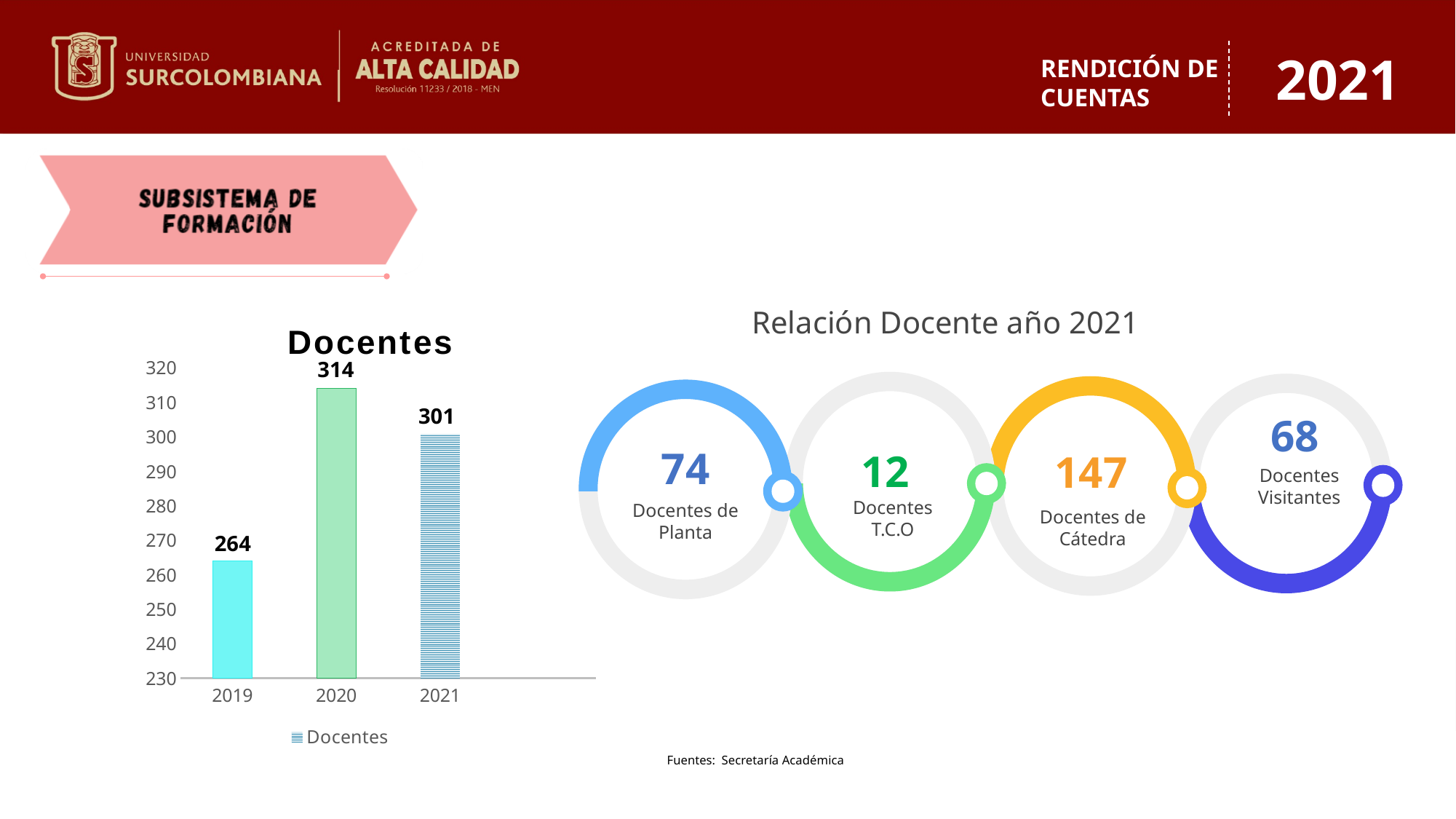
In the Docentes chart, which is larger, the value for 2021 or the value for 2019? 2021 In the Docentes chart, what is the value for 2020? 314 In the Docentes chart, what is the difference between the values for 2020 and 2021? 13 In the Docentes chart, which year has the highest value? 2020 What kind of chart is the Docentes chart? bar chart In the Docentes chart, which year has the lowest value? 2019 In the Docentes chart, what is the value for 2019? 264 How many years are shown on the x axis of the Docentes chart? 3 In the Docentes chart, what is the value for 2021? 301 In the Docentes chart, what is the difference between the values for 2020 and 2019? 50 How many series does the legend of the Docentes chart list? 1 In the Docentes chart, is the value for 2021 greater or less than 290? greater